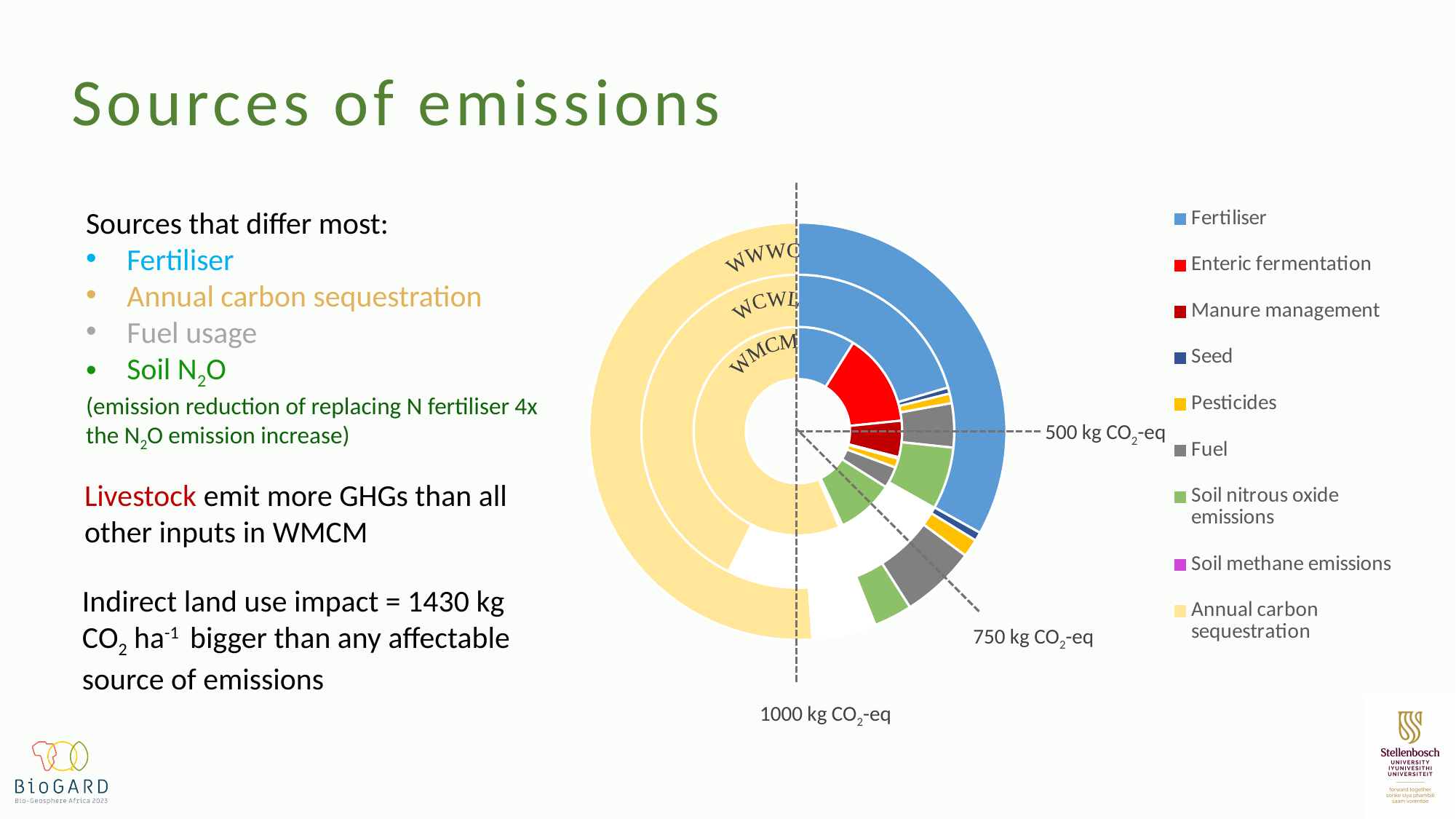
Which colour represents Annual carbon sequestration in the chart legend? light yellow What value does the dashed line pointing straight down from the chart mark? 1000 kg CO2-eq What value does the dashed line pointing to the right of the chart mark? 500 kg CO2-eq Which of the three rings contains an Enteric fermentation (red) segment? WMCM Which of the three rings contains a Manure management (dark red) segment? WMCM What kind of chart is shown on the slide? doughnut chart How many series does the chart legend list? 9 How many rings (systems) does the doughnut chart have? 3